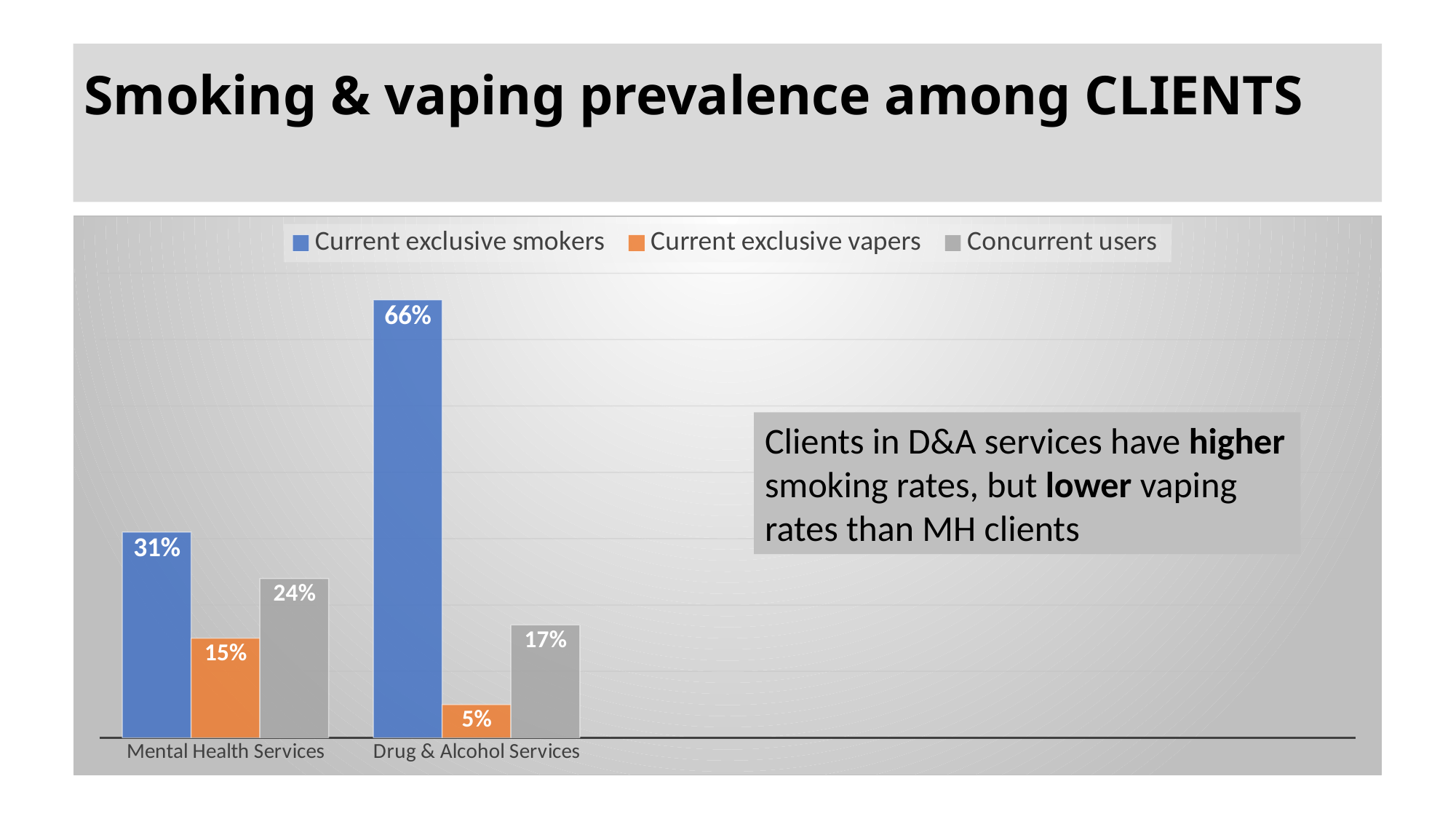
Which category has the highest value for Current exclusive smokers? Drug & Alcohol Services Which is larger: Concurrent users in Mental Health Services or Current exclusive vapers in Mental Health Services? Concurrent users in Mental Health Services How many categories are shown on the x axis? 2 What is the difference between Concurrent users in Mental Health Services and in Drug & Alcohol Services? 7% What is the value for Current exclusive smokers in Mental Health Services? 31% What kind of chart is shown on the slide? Bar chart What is the value for Current exclusive vapers in Mental Health Services? 15% What is the difference between Current exclusive smokers in Drug & Alcohol Services and in Mental Health Services? 35% What is the value for Current exclusive smokers in Drug & Alcohol Services? 66% What is the value for Concurrent users in Drug & Alcohol Services? 17% Which category has the lowest value for Current exclusive vapers? Drug & Alcohol Services How many series does the legend list? 3